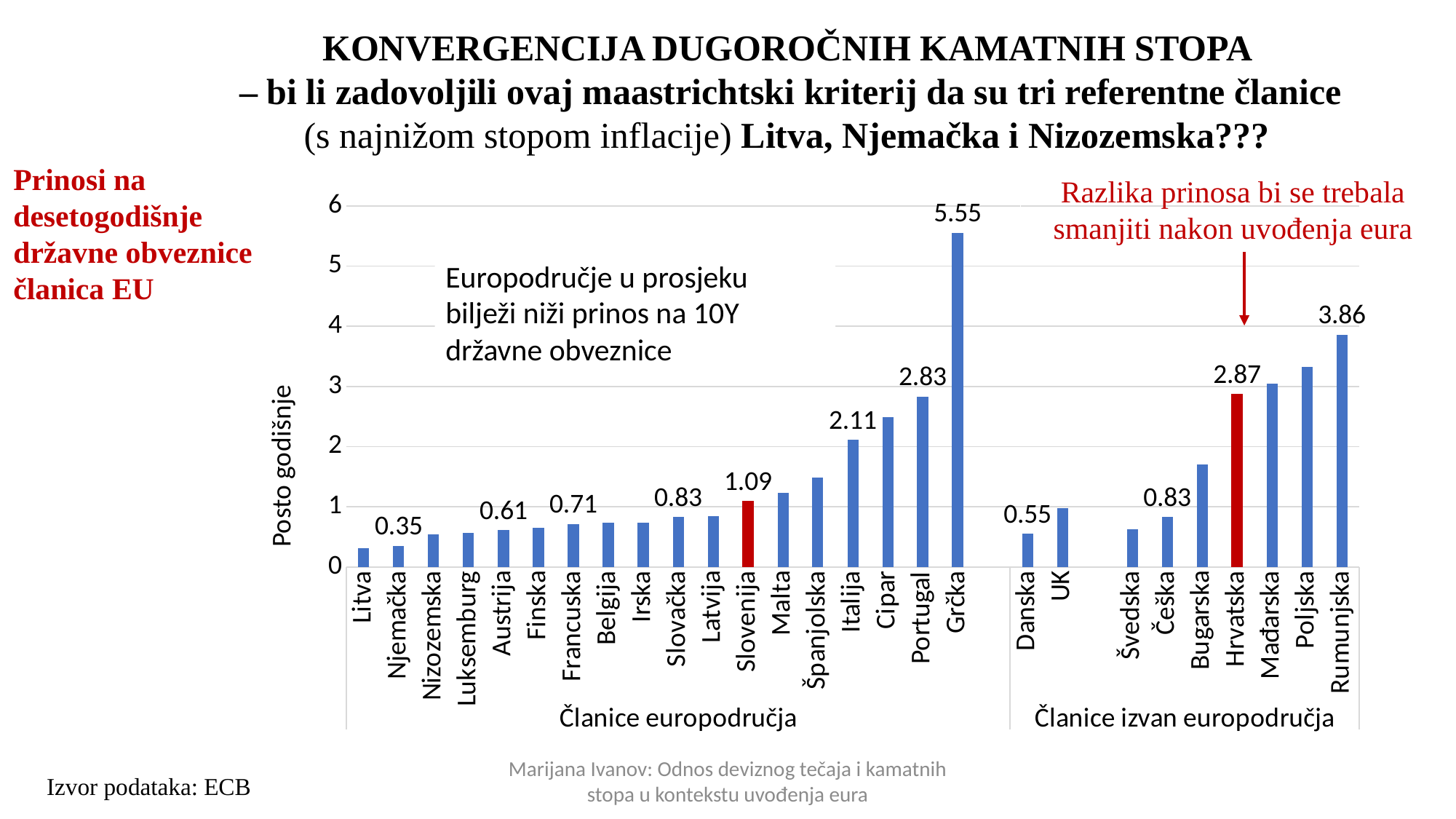
Is the value for Bugarska greater or less than 2? less What is the value shown for Grčka? 5.55 Is the value for Poljska greater or less than 3? greater What is the difference between the values for Grčka and Portugal? 2.72 How many countries are shown in the chart in total? 27 What kind of chart is shown on the slide? Bar chart What is the value shown for Hrvatska? 2.87 What is the difference between the values for Rumunjska and Hrvatska? 0.99 What is the value shown for Njemačka? 0.35 Which is larger, the value for Italija or the value for Slovenija? Italija Which country has the highest bar in the chart? Grčka What is the value shown for Danska? 0.55